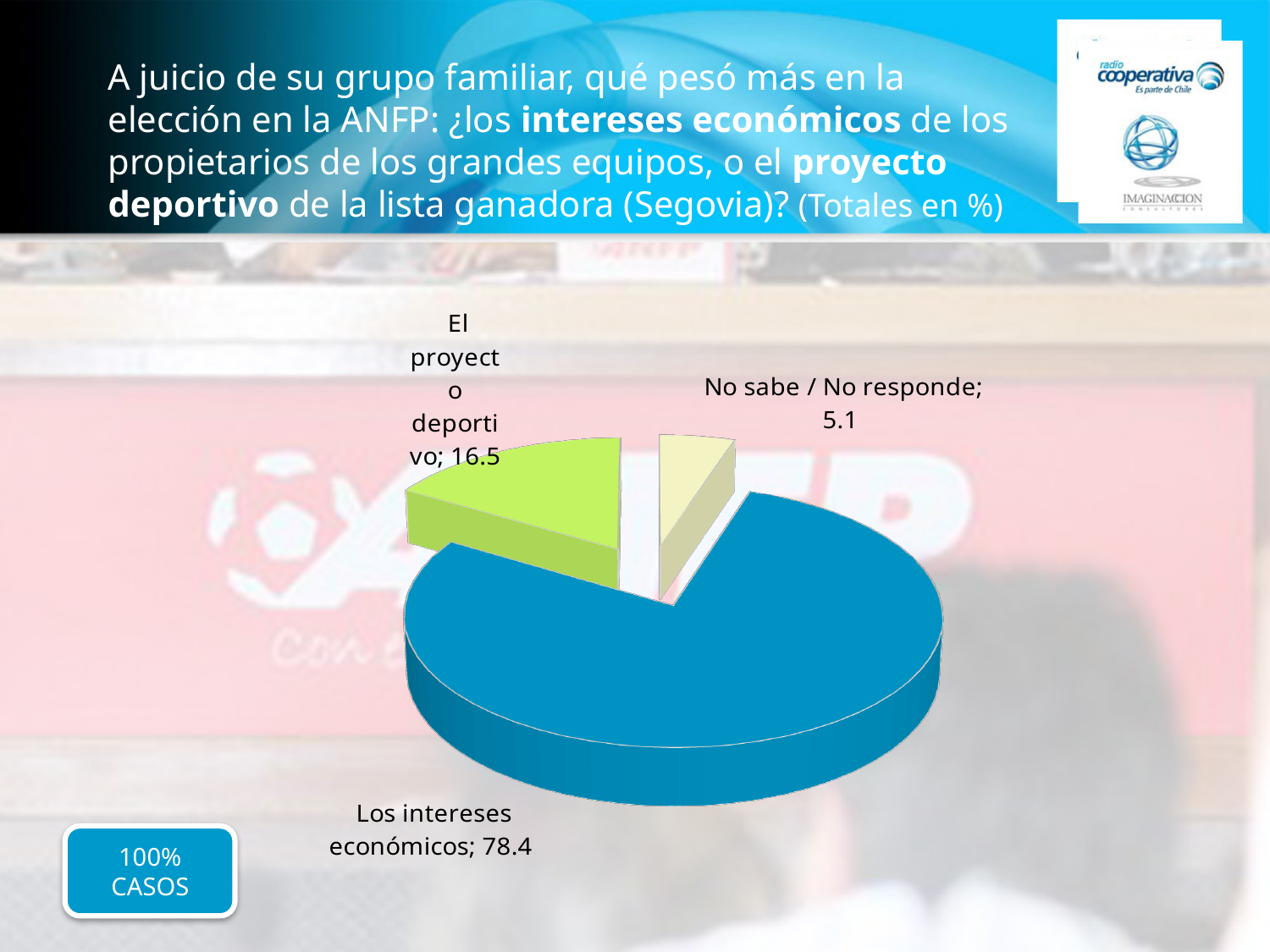
Which category has the largest slice of the pie? Los intereses económicos What colour is the slice for "Los intereses económicos"? blue What is the value for "No sabe / No responde"? 5.1 What colour is the slice for "El proyecto deportivo"? green Which category has the smallest slice of the pie? No sabe / No responde How many slices does the pie chart have? 3 What is the difference between the values for "Los intereses económicos" and "El proyecto deportivo"? 61.9 What kind of chart is shown on the slide? pie chart What is the value for "Los intereses económicos"? 78.4 Which is larger, the value for "El proyecto deportivo" or the value for "No sabe / No responde"? El proyecto deportivo What is the value for "El proyecto deportivo"? 16.5 What is the difference between the values for "El proyecto deportivo" and "No sabe / No responde"? 11.4